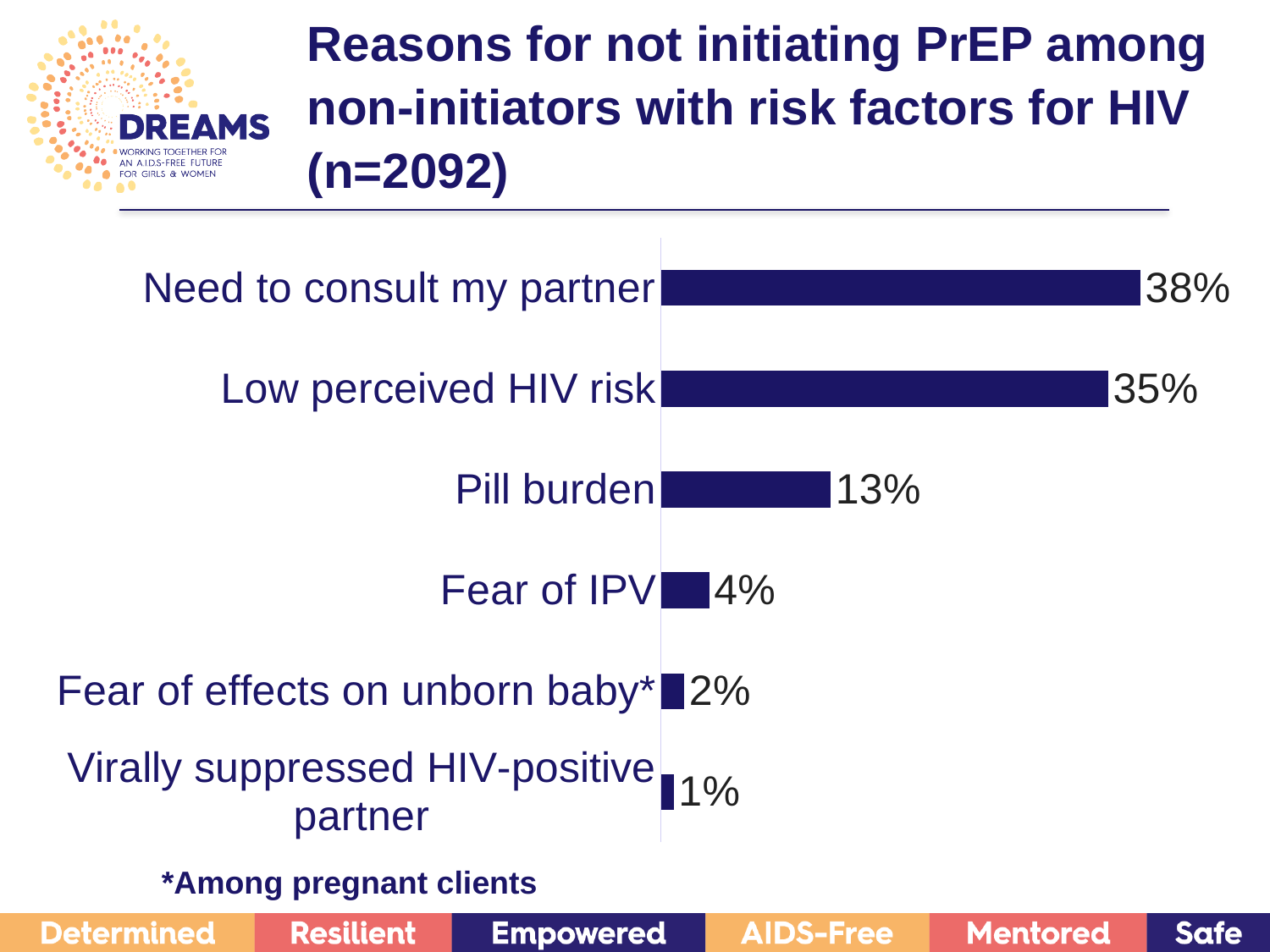
How many reasons (categories) are shown in the chart? 6 What percentage is shown for 'Virally suppressed HIV-positive partner'? 1% According to the footnote, which group does the 'Fear of effects on unborn baby*' category refer to? Pregnant clients What type of chart is shown on the slide? Bar chart What is the difference in percentage points between 'Need to consult my partner' and 'Low perceived HIV risk'? 3 percentage points What is the value shown for 'Low perceived HIV risk'? 35% Which is larger: the value for 'Pill burden' or the value for 'Fear of IPV'? Pill burden What is the value for 'Fear of IPV'? 4% What percentage of non-initiators cited 'Need to consult my partner' as a reason for not initiating PrEP? 38% What percentage is shown for 'Pill burden'? 13% Which reason has the highest percentage? Need to consult my partner Which reason has the lowest percentage? Virally suppressed HIV-positive partner